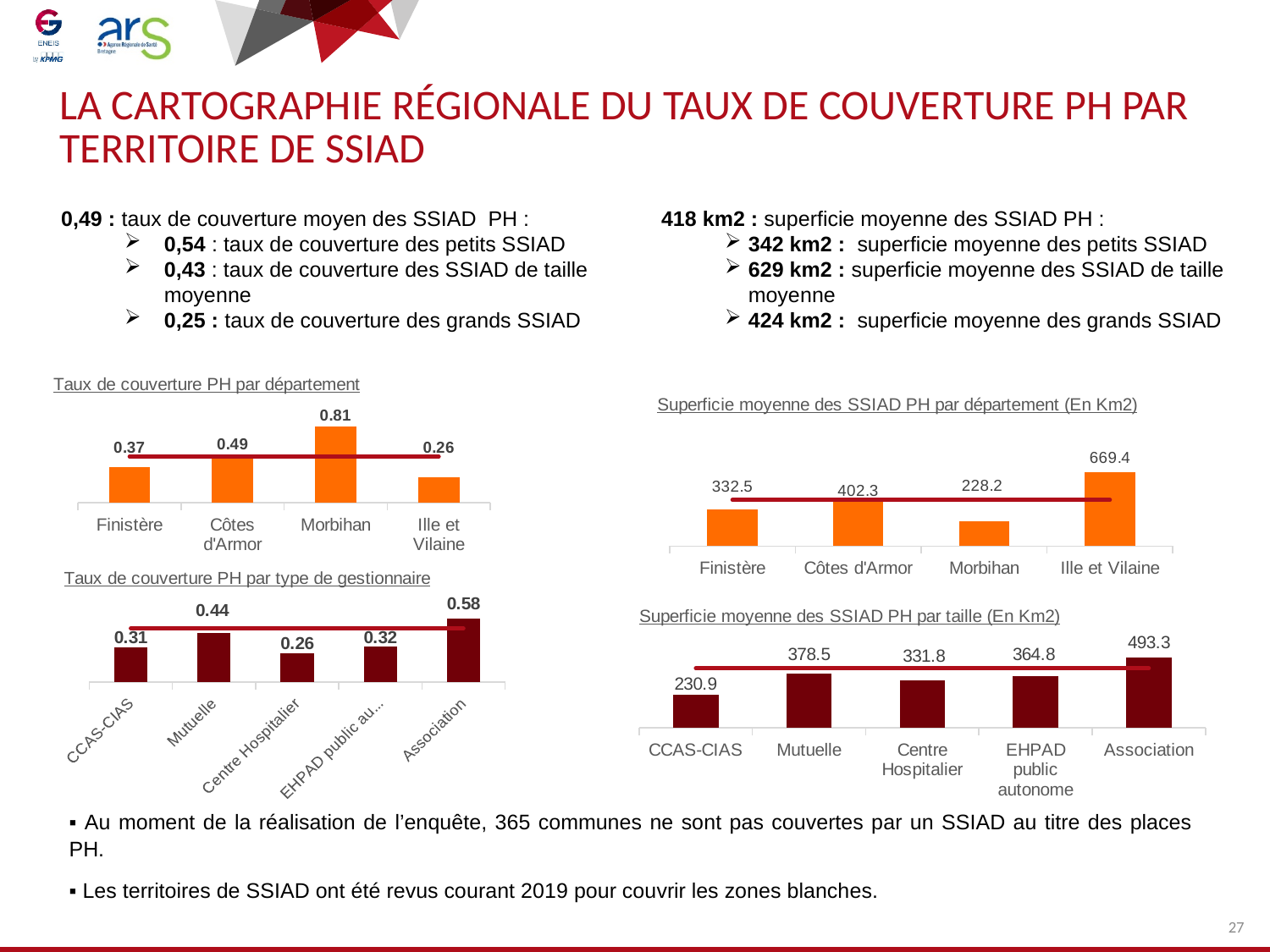
In the chart 'Superficie moyenne des SSIAD PH par taille (En Km2)', what is the difference between Association and Mutuelle? 114.8 In the chart 'Superficie moyenne des SSIAD PH par département (En Km2)', which is larger, Finistère or Morbihan? Finistère In the chart 'Taux de couverture PH par département', what is the difference between Morbihan and Finistère? 0.44 In the chart 'Taux de couverture PH par département', which department has the lowest value? Ille et Vilaine In the chart 'Taux de couverture PH par type de gestionnaire', how many categories are shown? 5 What type of chart is 'Superficie moyenne des SSIAD PH par taille (En Km2)'? Bar chart In the chart 'Superficie moyenne des SSIAD PH par département (En Km2)', what is the value for Côtes d'Armor? 402.3 In the chart 'Taux de couverture PH par type de gestionnaire', which category has the highest value? Association In the chart 'Superficie moyenne des SSIAD PH par département (En Km2)', which department has the highest value? Ille et Vilaine In the chart 'Taux de couverture PH par département', what is the value for Morbihan? 0.81 In the chart 'Taux de couverture PH par type de gestionnaire', what is the value for Mutuelle? 0.44 In the chart 'Superficie moyenne des SSIAD PH par taille (En Km2)', what is the value for CCAS-CIAS? 230.9